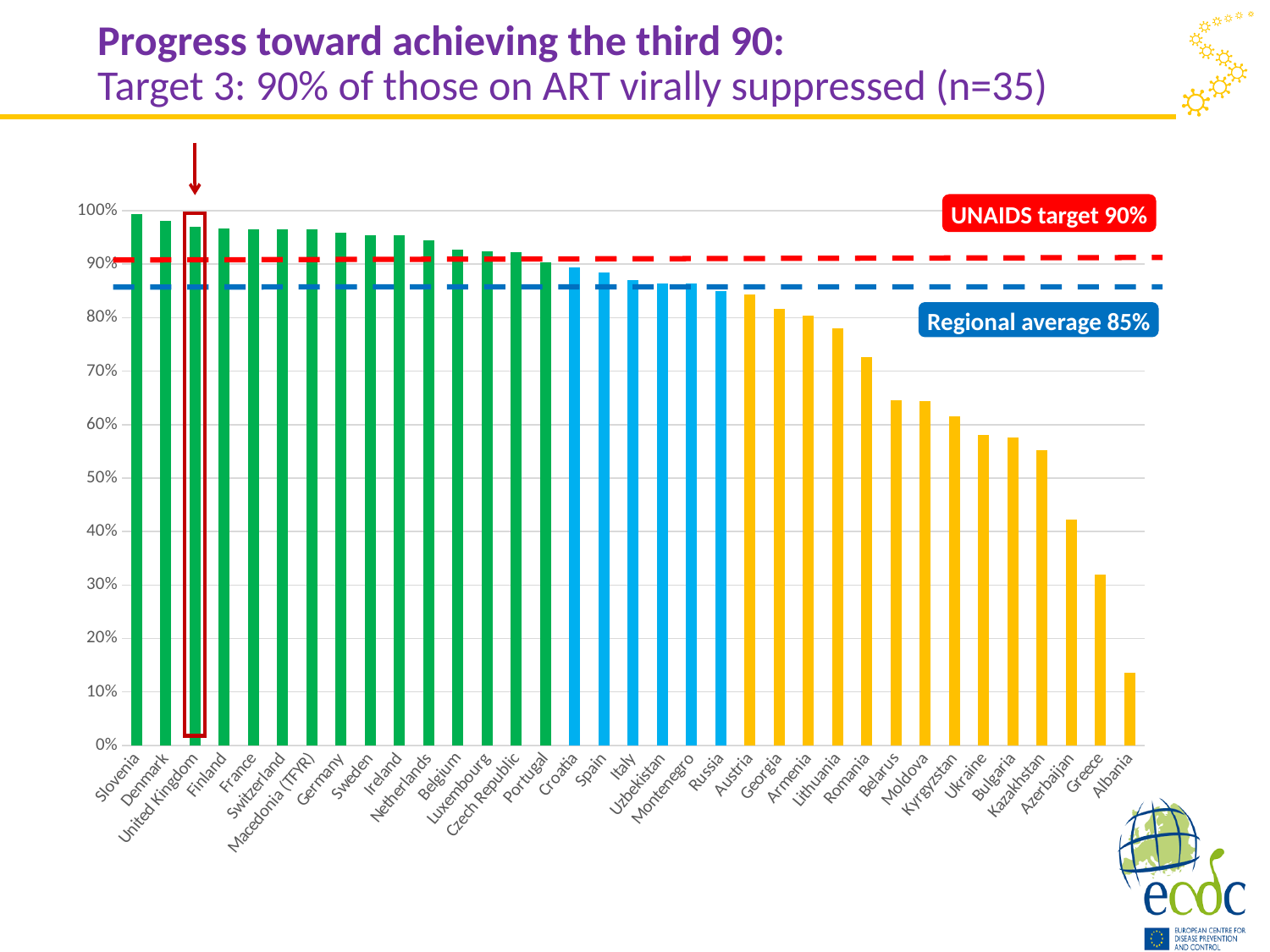
Which country has the highest percentage of those on ART virally suppressed? Slovenia Is the value for Belarus greater or less than 70%? less What value does the red dashed line labelled UNAIDS target represent? 90% Which country is highlighted with a red box and arrow in the chart? United Kingdom Is the value for Albania greater or less than 20%? less What kind of chart is shown on the slide? Bar chart Which has a higher value, Romania or Belarus? Romania Which country has the lowest percentage of those on ART virally suppressed? Albania How many countries are plotted in the chart? 35 Is the value for Austria greater or less than 90%? less Do the bar values rise or fall moving from left to right along the x axis? Fall